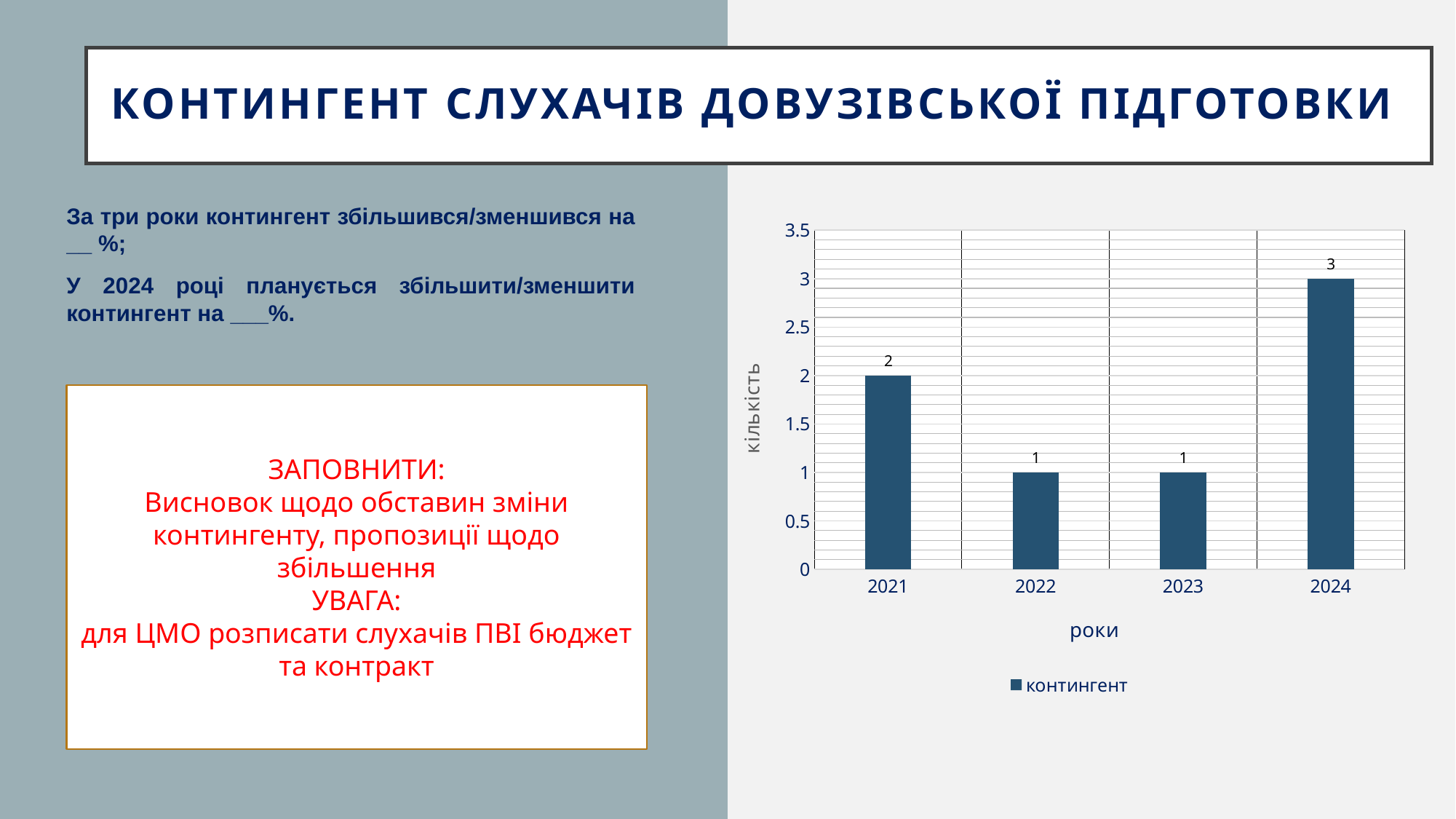
Is the value for 2024 greater or less than 2.5? greater Which year has the highest value? 2024 What kind of chart is shown? bar chart What is the difference between the values for 2024 and 2021? 1 What is the value for 2024? 3 What is the legend entry of the series? контингент What is the label of the y axis? кількість How many years are shown on the x axis? 4 What is the value for 2021? 2 What is the value for 2022? 1 Which is larger, the value for 2021 or the value for 2023? 2021 How many series does the legend list? 1